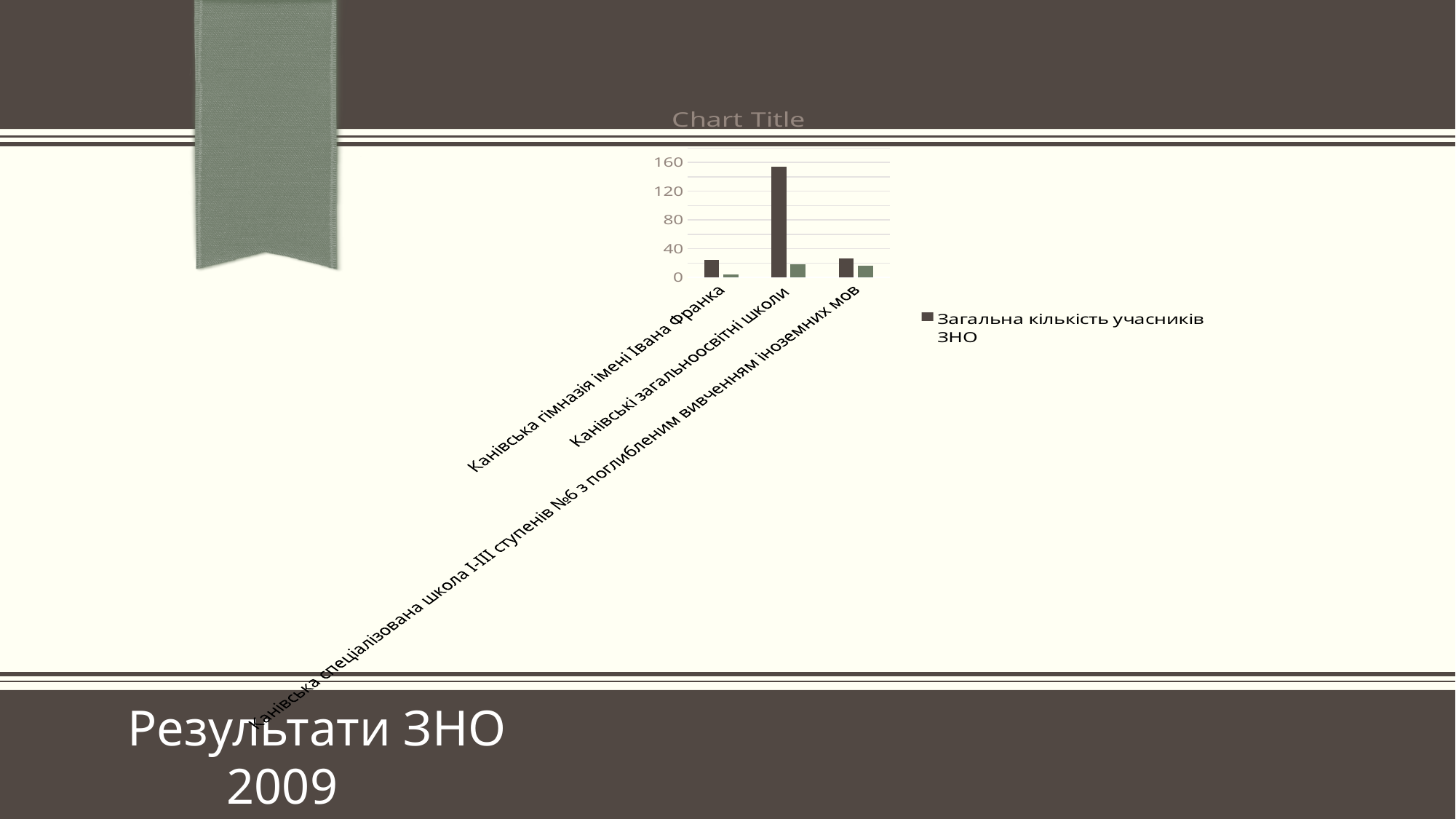
What series name is shown in the chart legend? Загальна кількість учасників ЗНО For 'Канівські загальноосвітні школи', which bar is taller: the dark bar or the green bar? the dark bar Is the value of 'Загальна кількість учасників ЗНО' for 'Канівська гімназія імені Івана Франка' greater or less than 40? less Is the value of 'Загальна кількість учасників ЗНО' for 'Канівські загальноосвітні школи' greater or less than 120? greater Which is larger: the 'Загальна кількість учасників ЗНО' value for 'Канівські загальноосвітні школи' or for 'Канівська гімназія імені Івана Франка'? Канівські загальноосвітні школи What kind of chart is shown on the slide? bar chart How many categories are shown on the x axis of the chart? 3 What is the title shown above the chart? Chart Title Which category has the highest value for the series 'Загальна кількість учасників ЗНО'? Канівські загальноосвітні школи Which category has the lowest green bar? Канівська гімназія імені Івана Франка Is the green bar for 'Канівські загальноосвітні школи' greater or less than 40? less